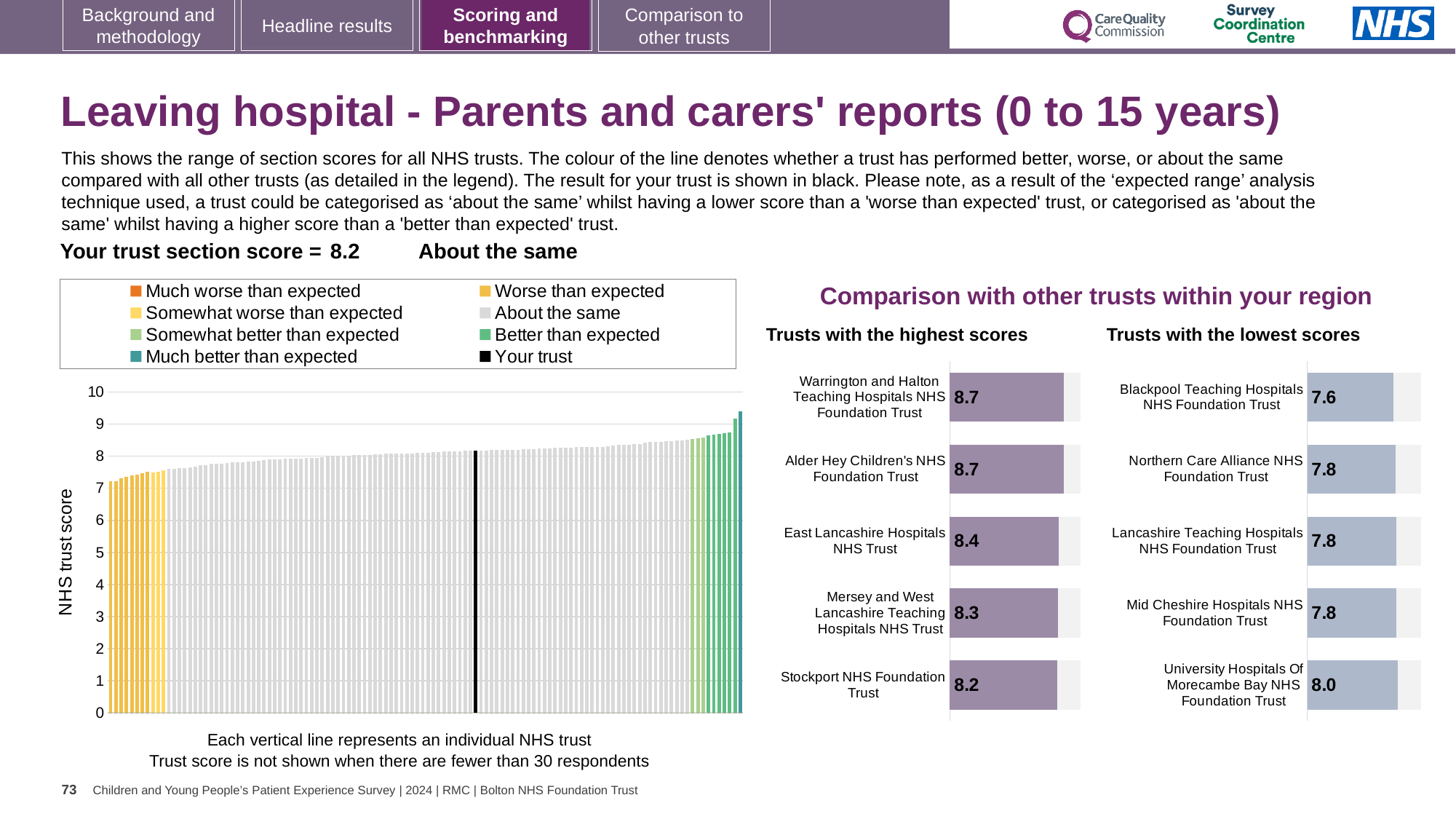
What is the y-axis label of the large chart on the left? NHS trust score How many entries does the legend above the large chart on the left list? 8 In the 'Trusts with the lowest scores' chart, which trust has the highest score? University Hospitals Of Morecambe Bay NHS Foundation Trust What is the difference between the score for Warrington and Halton Teaching Hospitals NHS Foundation Trust in the highest-scores chart and the score for Blackpool Teaching Hospitals NHS Foundation Trust in the lowest-scores chart? 1.1 In the 'Trusts with the lowest scores' chart, what is the difference between the scores for University Hospitals Of Morecambe Bay NHS Foundation Trust and Blackpool Teaching Hospitals NHS Foundation Trust? 0.4 How many trusts are shown in the 'Trusts with the lowest scores' chart? 5 In the 'Trusts with the highest scores' chart, which trust has the lowest score? Stockport NHS Foundation Trust In the 'Trusts with the highest scores' chart, what is the score for East Lancashire Hospitals NHS Trust? 8.4 In the 'Trusts with the highest scores' chart, which has the larger score: Mersey and West Lancashire Teaching Hospitals NHS Trust or Stockport NHS Foundation Trust? Mersey and West Lancashire Teaching Hospitals NHS Trust In the 'Trusts with the lowest scores' chart, what is the score for Blackpool Teaching Hospitals NHS Foundation Trust? 7.6 In the large chart on the left, do the trust scores rise or fall from left to right along the x axis? Rise What kind of chart is the large chart on the left showing NHS trust scores? Bar chart